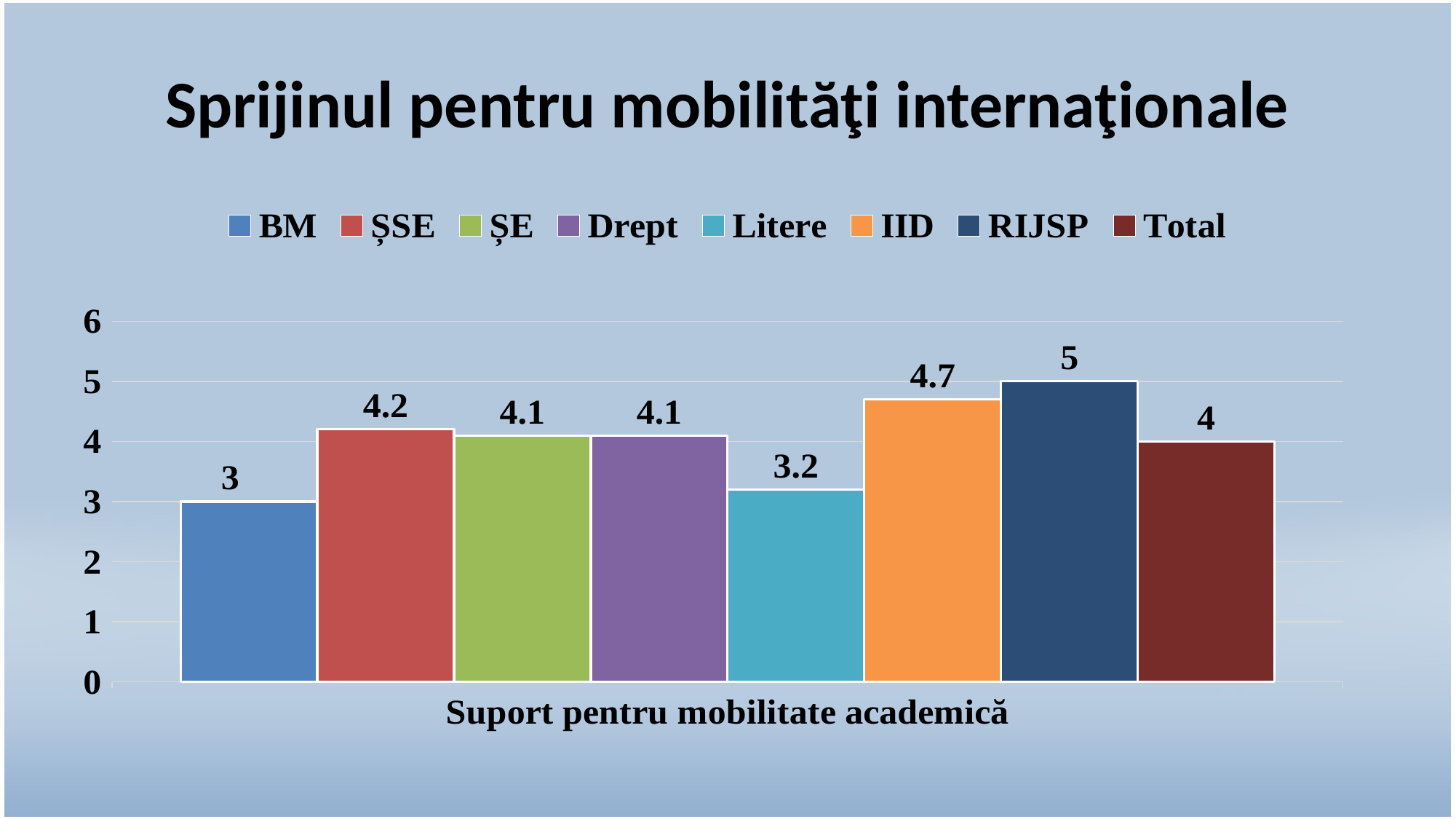
How many series does the legend list? 8 Which series has the highest value? RIJSP What is the value for BM? 3 Which series has the lowest value? BM What is the value for Litere? 3.2 What is the title of the slide? Sprijinul pentru mobilităţi internaţionale What is the difference between the values for RIJSP and BM? 2 What is the difference between the values for ȘSE and Litere? 1 What is the value for Total? 4 What is the value for IID? 4.7 What kind of chart is shown on the slide? bar chart Which is larger, the value for IID or the value for Drept? IID